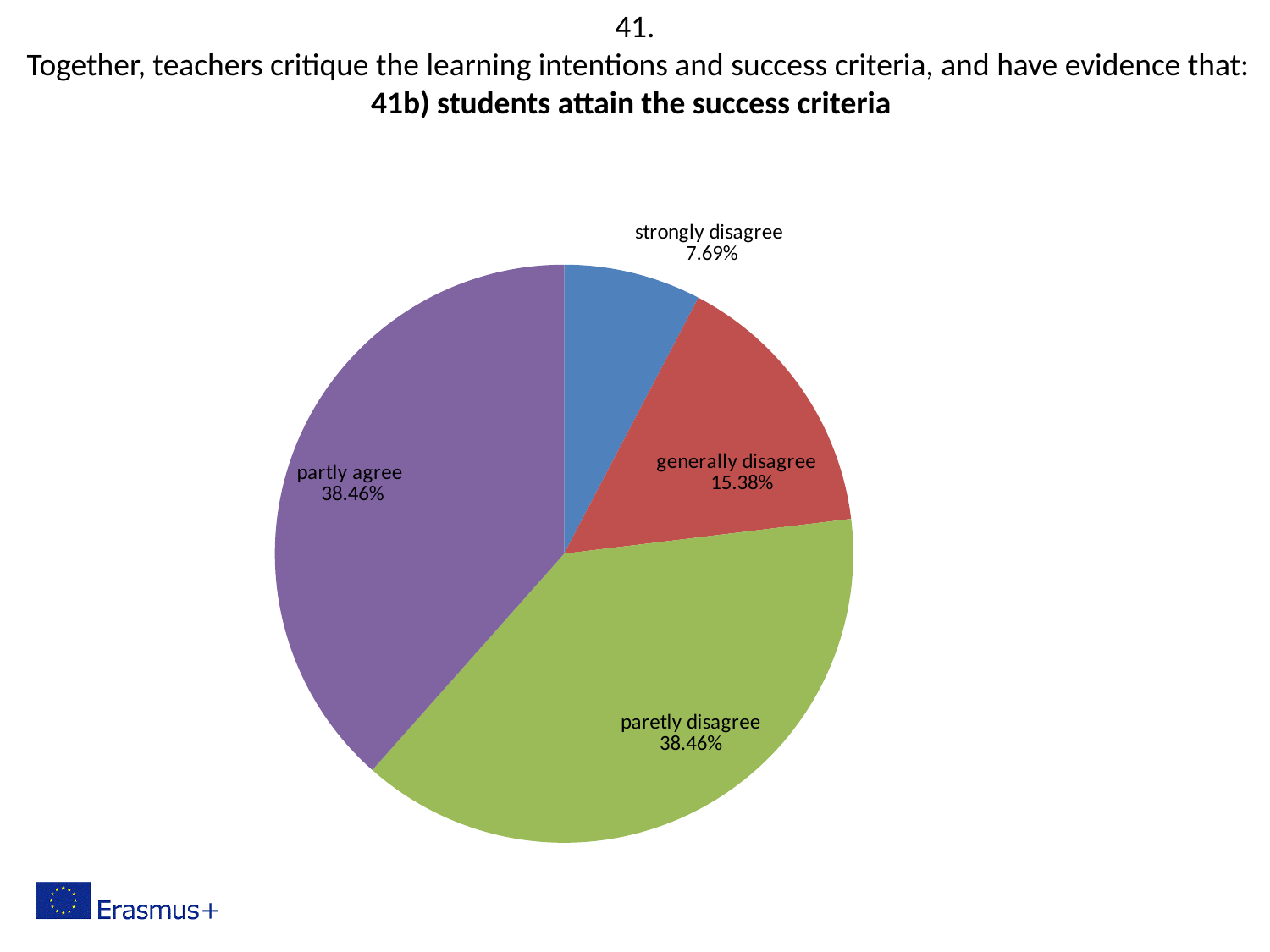
Which category has the smallest slice of the pie? strongly disagree What share of the pie is labelled 'paretly disagree'? 38.46% What share of the pie is labelled 'strongly disagree'? 7.69% What kind of chart is shown on the slide? pie chart What share of the pie is labelled 'generally disagree'? 15.38% What is the difference between the 'generally disagree' and 'strongly disagree' shares? 7.69% What colour is the 'partly agree' slice? purple What is the difference between the 'partly agree' and 'generally disagree' shares? 23.08% Which is larger, the 'partly agree' slice or the 'generally disagree' slice? partly agree How many slices does the pie chart have? 4 What share of the pie is labelled 'partly agree'? 38.46% Which is larger, the 'generally disagree' slice or the 'strongly disagree' slice? generally disagree